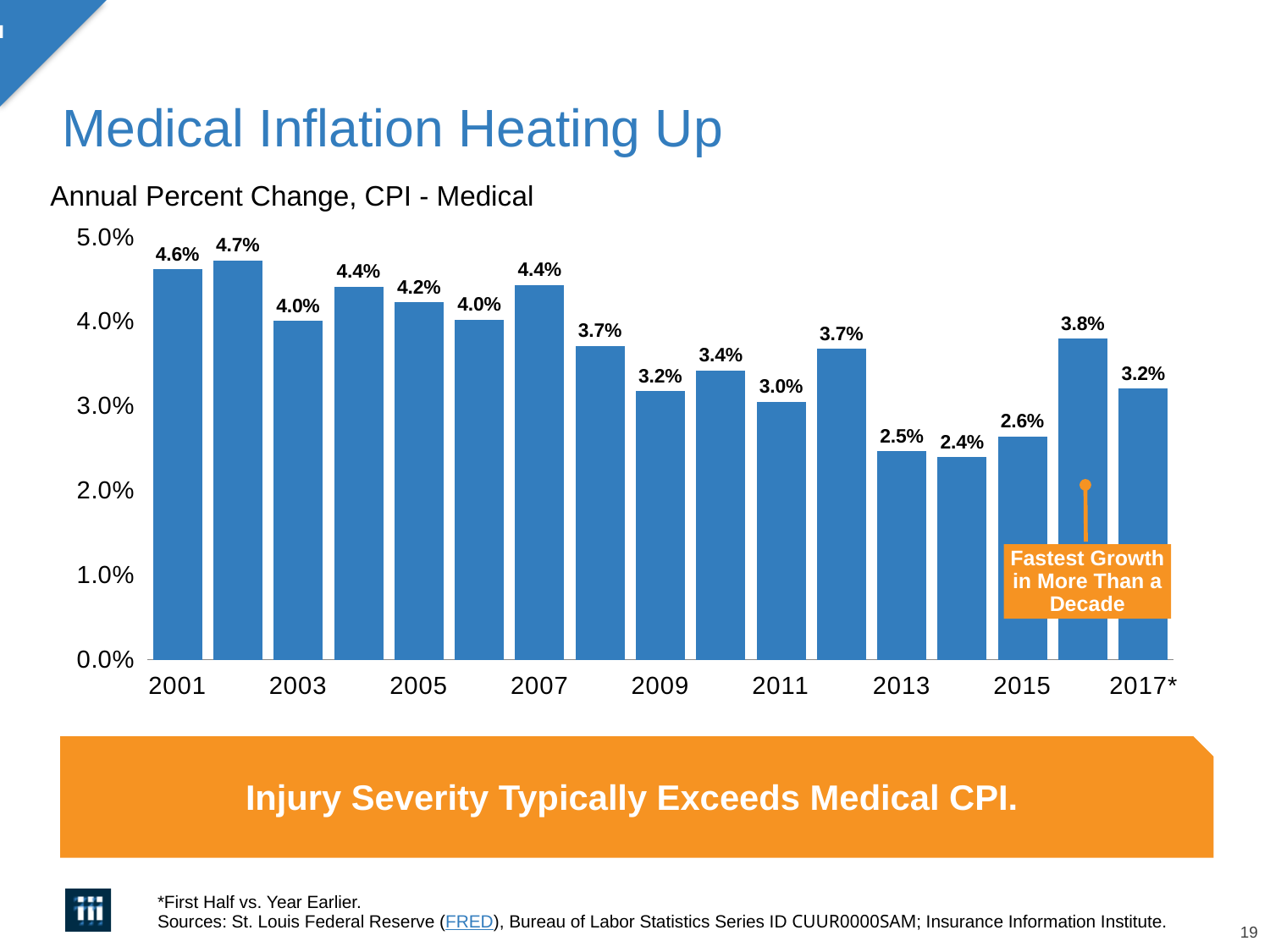
What does the orange callout on the chart say? Fastest Growth in More Than a Decade Is the value for 2003 greater or less than 3.0%? greater Which year has the highest value on the chart? 2002 (the bar immediately after 2001), 4.7% What is the value shown for 2013? 2.5% What is the annual percent change in CPI - Medical for 2001? 4.6% Which labeled year has the lowest value on the chart? 2013 What is the value shown for 2011? 3.0% What is the difference between the values for 2007 and 2009? 1.2 percentage points What is the value shown for 2017*? 3.2% How many bars are plotted on the chart? 17 Which is larger, the value for 2005 or the value for 2015? 2005 What kind of chart is shown on the slide? Bar chart